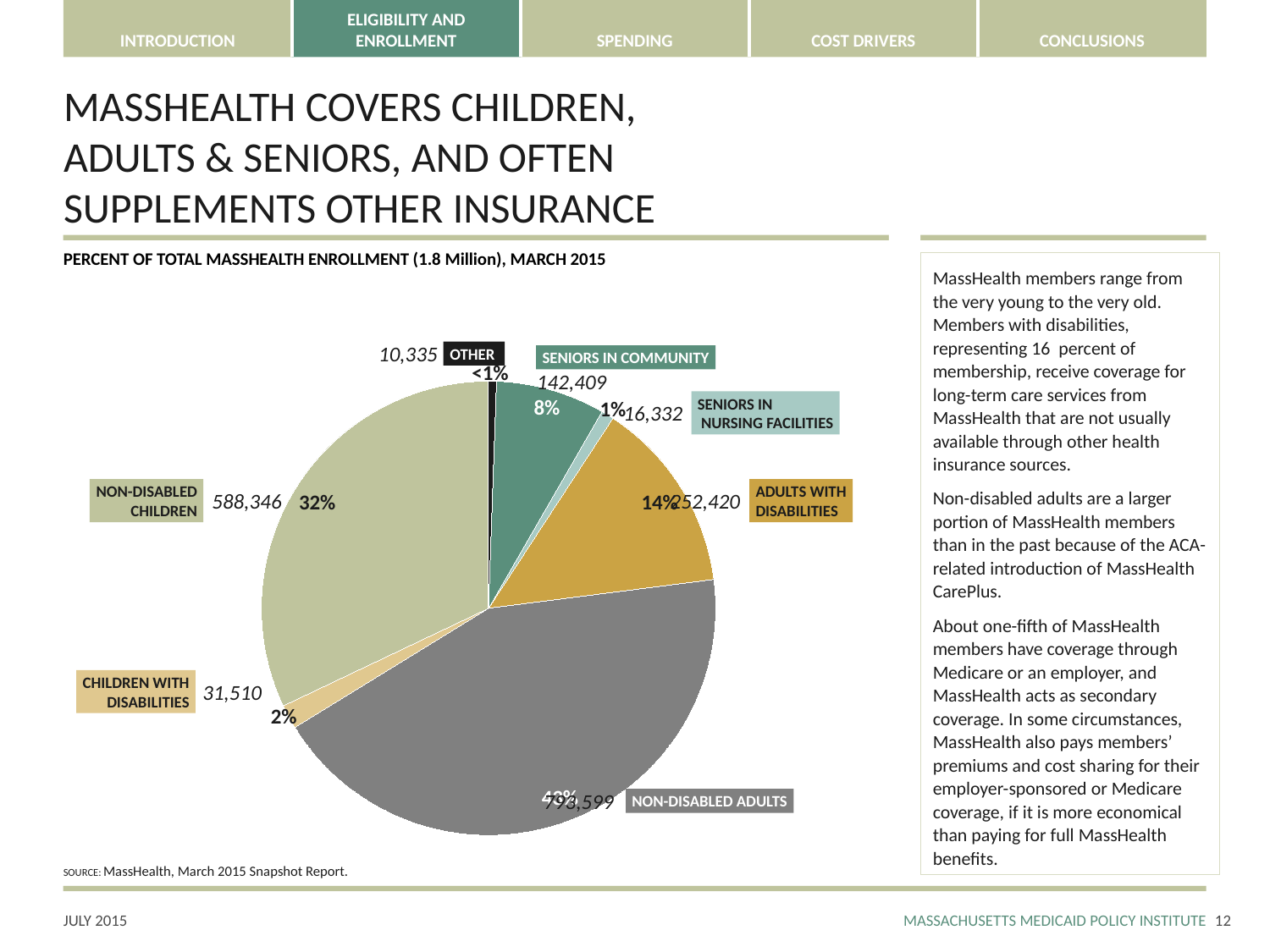
What is the enrollment value for Children with Disabilities? 31,510 What percentage share of enrollment is Seniors in Community? 8% What is the enrollment value for Seniors in Community? 142,409 What percentage share of enrollment is Non-Disabled Children? 32% What is the enrollment value for Adults with Disabilities? 252,420 Which category has the smallest share of enrollment? Other What type of chart is shown on the slide? pie chart Which category has the largest share of enrollment? Non-Disabled Adults How many categories does the pie chart show? 7 What is the enrollment value for Non-Disabled Adults? 793,599 What is the enrollment value for Non-Disabled Children? 588,346 What is the chart's title? PERCENT OF TOTAL MASSHEALTH ENROLLMENT (1.8 Million), MARCH 2015